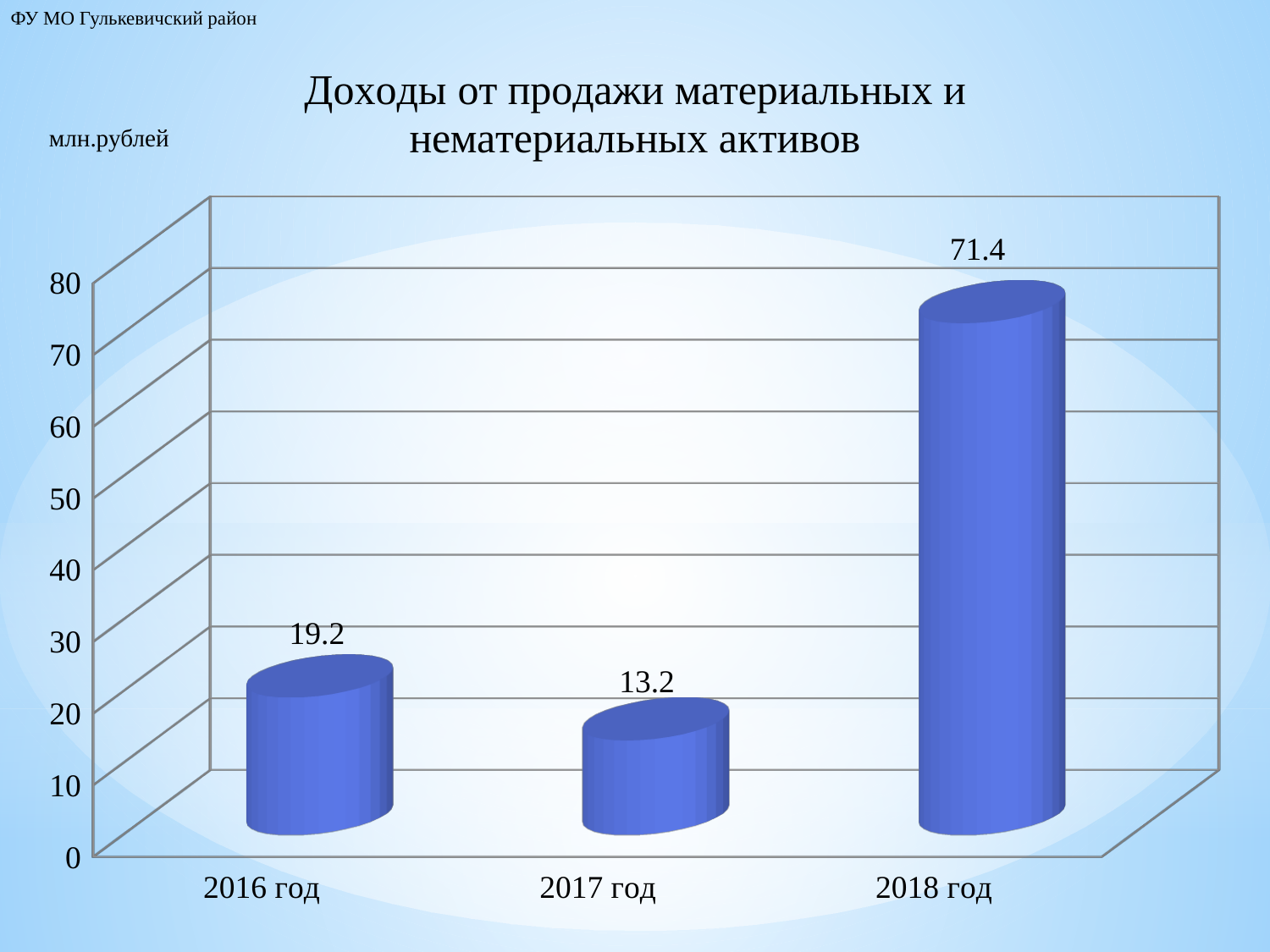
Is the value for 2018 год greater or less than 70? greater What is the value for 2016 год? 19.2 Which year has the lowest value? 2017 год How many years are shown on the chart? 3 What is the value for 2018 год? 71.4 What is the value for 2017 год? 13.2 What unit of measurement is indicated for the chart? млн.рублей What is the difference between the values for 2016 год and 2017 год? 6 What is the difference between the values for 2018 год and 2016 год? 52.2 Which is larger, the value for 2016 год or 2017 год? 2016 год What kind of chart is shown on the slide? bar chart Which year has the highest value? 2018 год